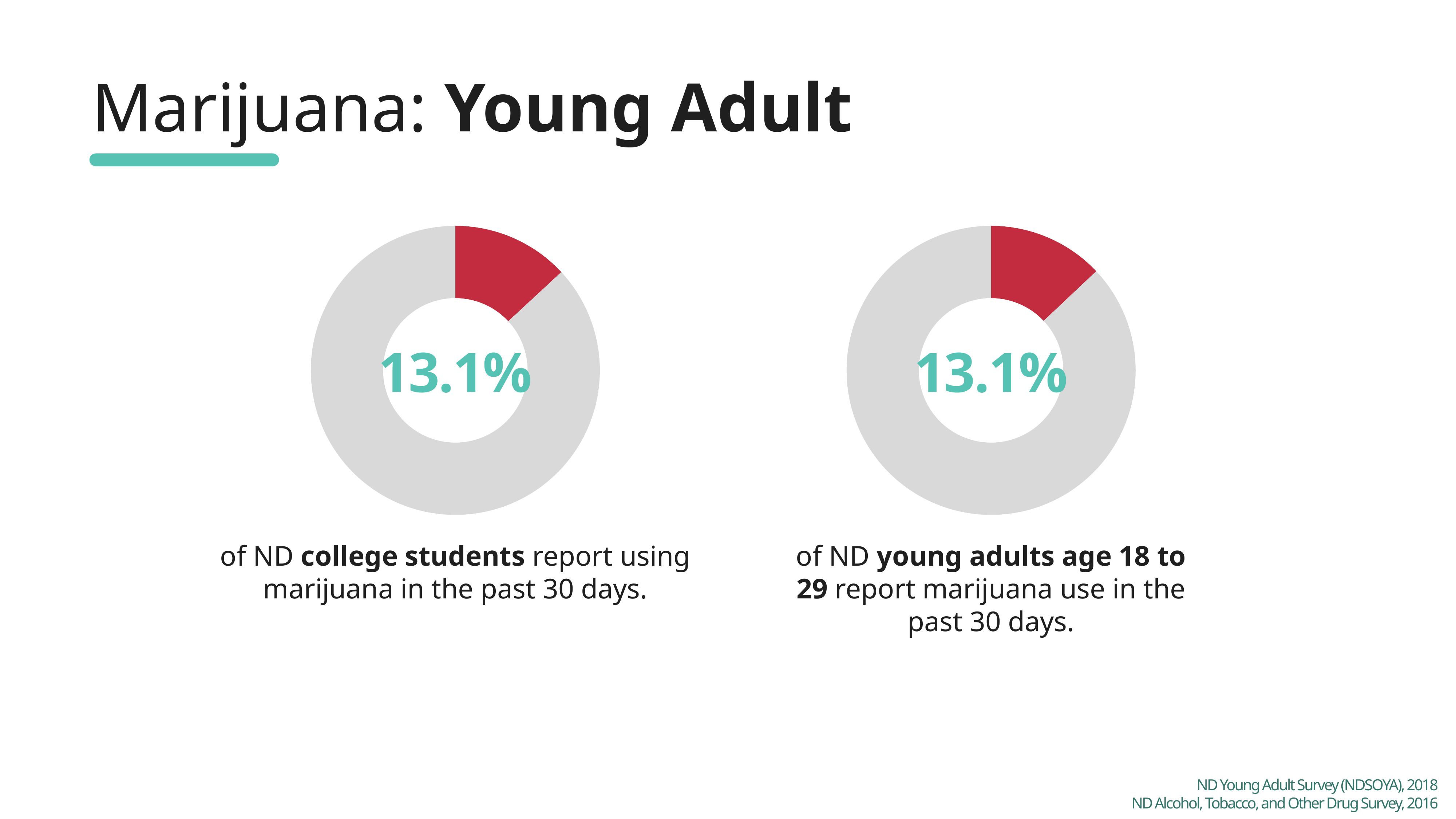
On the right chart, what share of the doughnut does the red slice represent? 13.1% What is the difference between the percentage shown on the left chart and the percentage shown on the right chart? 0% On the left chart, what percentage of ND college students report using marijuana in the past 30 days? 13.1% Is the percentage of ND college students reporting marijuana use in the past 30 days (left chart) greater or less than 50%? less On the right chart, what percentage of ND young adults age 18 to 29 report marijuana use in the past 30 days? 13.1% How many doughnut charts are shown on the slide? 2 What kind of chart is used on the right side of the slide? Doughnut chart Is the percentage of ND young adults age 18 to 29 reporting marijuana use (right chart) greater or less than 25%? less On the left chart, what share of the doughnut does the red slice represent? 13.1% What kind of chart is used on the left side of the slide? Doughnut chart What colour is the highlighted slice representing marijuana use in both doughnut charts? Red What is the title of the slide containing the two doughnut charts? Marijuana: Young Adult